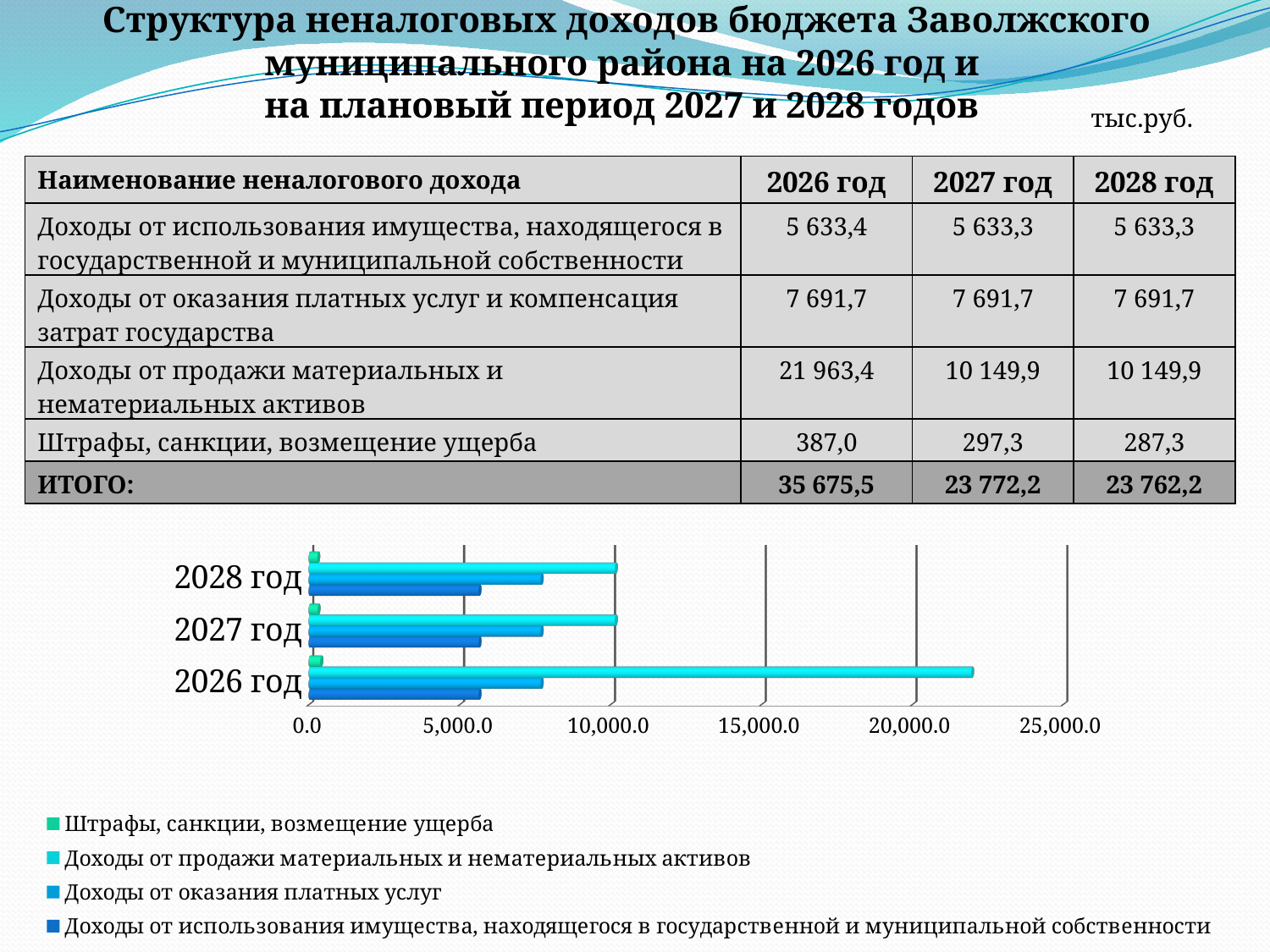
According to the slide, what is the difference between the 2026 год and 2027 год values for 'Доходы от продажи материальных и нематериальных активов'? 11 813,5 Do the values for 'Штрафы, санкции, возмещение ущерба' rise or fall from 2026 год to 2028 год? fall In 2026 год, which is larger: 'Доходы от оказания платных услуг' or 'Доходы от использования имущества, находящегося в государственной и муниципальной собственности'? Доходы от оказания платных услуг According to the slide, what is the value of 'Штрафы, санкции, возмещение ущерба' for 2026 год? 387,0 In the chart, is the value for 'Доходы от продажи материальных и нематериальных активов' in 2026 год greater or less than 20,000.0? greater Which year has the longest bar for 'Доходы от продажи материальных и нематериальных активов'? 2026 год How many series does the chart legend list? 4 In the chart, is the value for 'Доходы от использования имущества, находящегося в государственной и муниципальной собственности' in 2028 год greater or less than 5,000.0? greater What type of chart is shown on the slide? Bar chart Which series is listed first in the chart legend? Штрафы, санкции, возмещение ущерба In the chart, is the value for 'Доходы от продажи материальных и нематериальных активов' in 2027 год greater or less than 15,000.0? less How many year categories are shown on the chart's vertical axis? 3